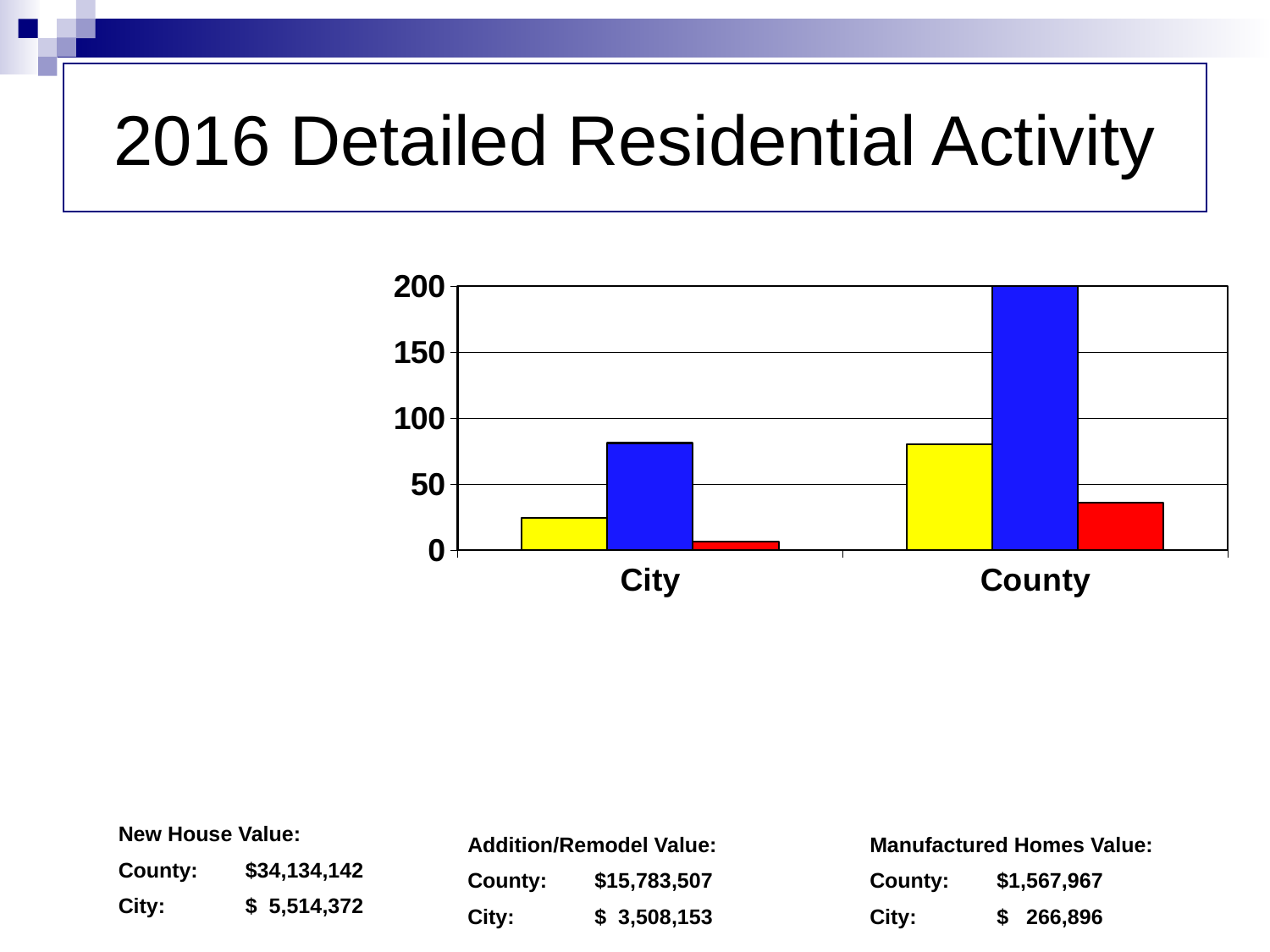
What kind of chart is shown on the slide? bar chart Which category has the larger blue bar, City or County? County Is the value of the yellow bar for City greater or less than 50? less How many bars are plotted for each category in the chart? 3 Which bar is the shortest in the chart? the red bar for City Which category has the larger yellow bar, City or County? County Is the value of the red bar for County greater or less than 50? less How many categories are shown on the x axis of the chart? 2 Which category contains the tallest bar in the chart? County Is the value of the blue bar for County greater or less than 150? greater